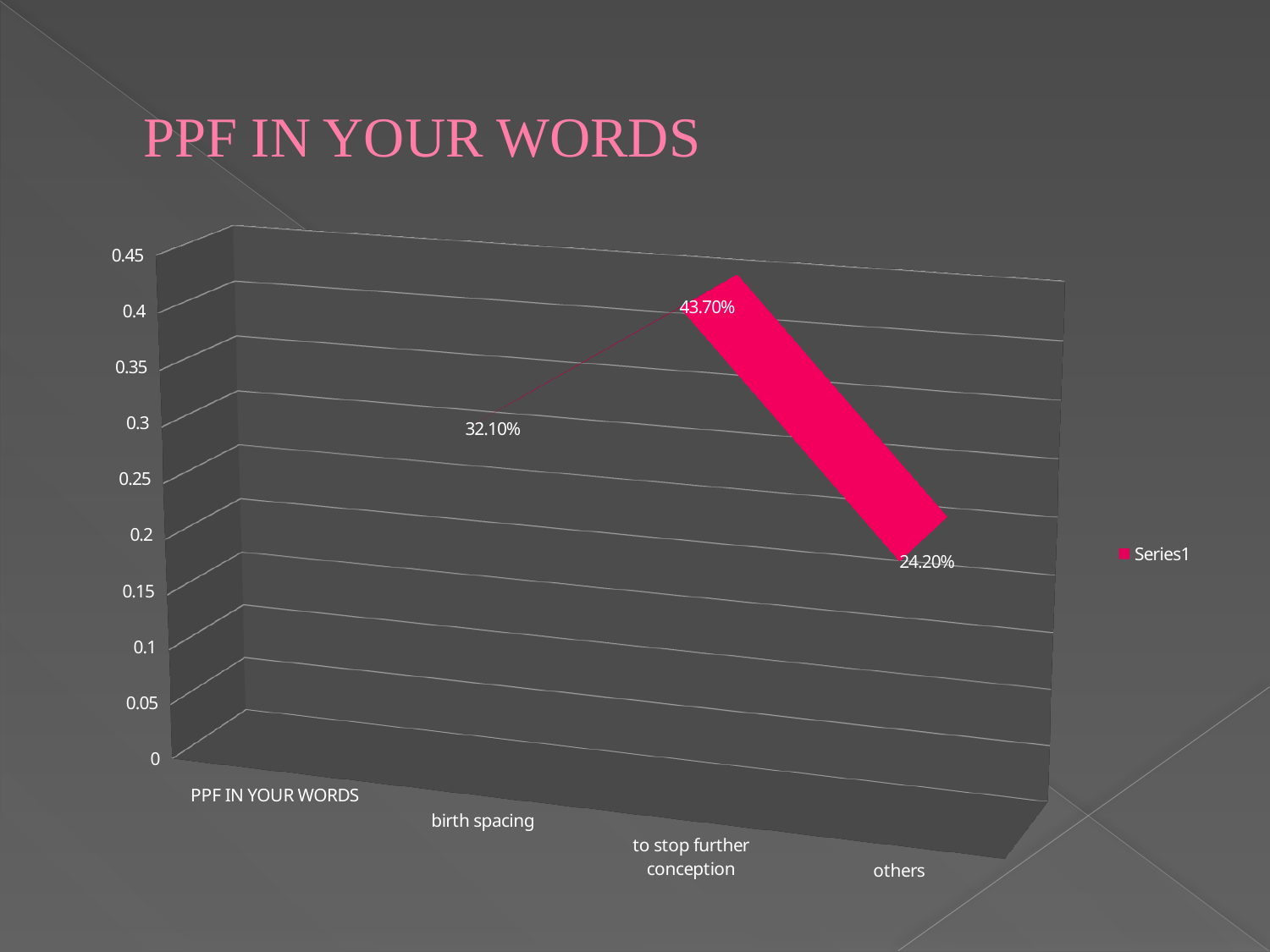
What is the value for others? 24.20% What is the value for to stop further conception? 43.70% What is the difference between the values for to stop further conception and birth spacing? 11.60% Which category has the lowest value? others Which is larger, the value for birth spacing or the value for others? birth spacing What is the title of the slide? PPF IN YOUR WORDS What is the difference between the values for birth spacing and others? 7.90% What kind of chart is shown on the slide? line chart Which category has the highest value? to stop further conception How many series does the legend list? 1 What is the value for birth spacing? 32.10% Is the value for others greater or less than 0.3? less